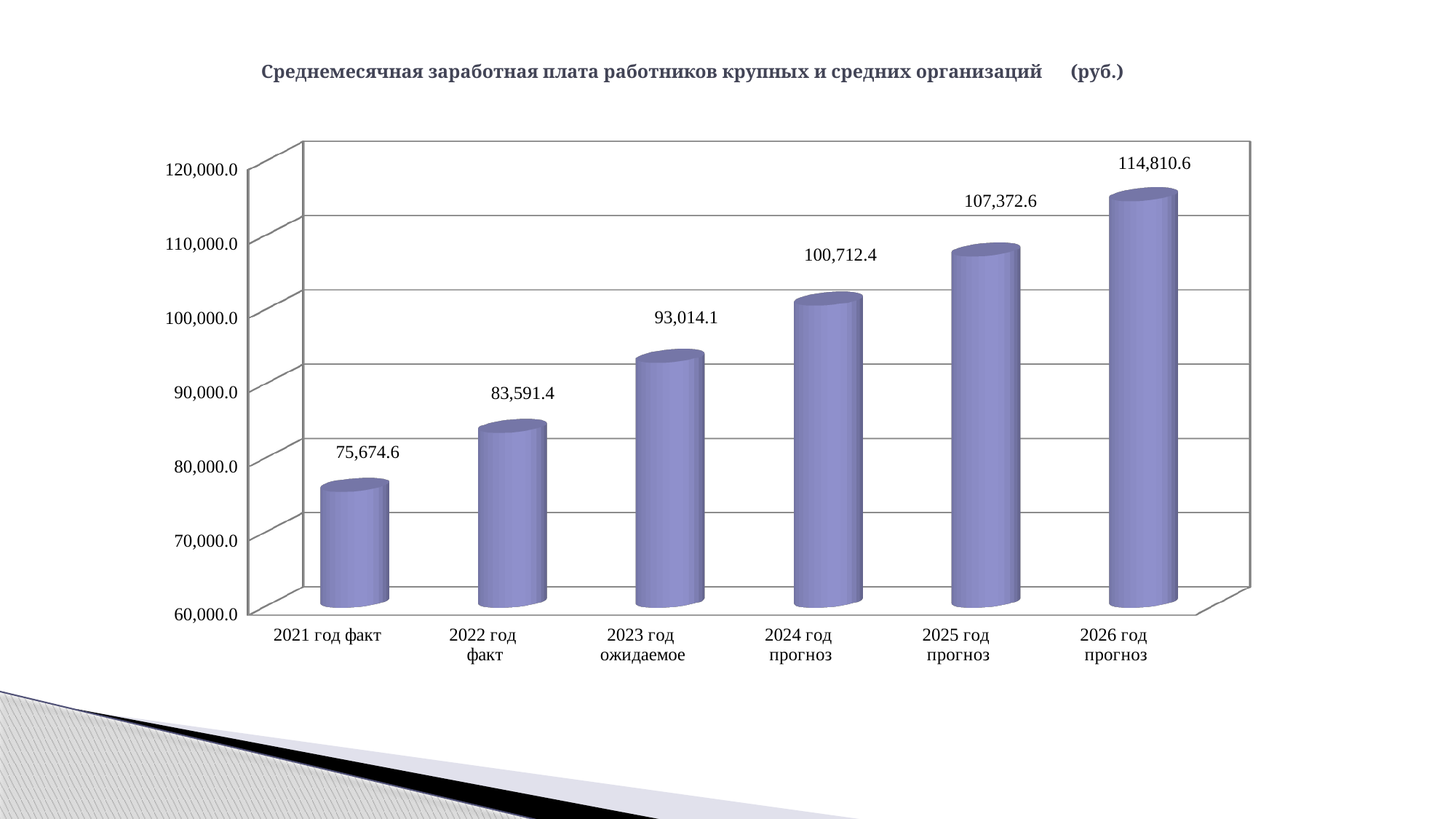
What is the difference between the values for 2022 год факт and 2021 год факт? 7,916.8 What is the value for 2025 год прогноз? 107,372.6 What is the value for 2023 год ожидаемое? 93,014.1 Is the value for 2024 год прогноз greater or less than 100,000.0? greater Which is larger, the value for 2024 год прогноз or the value for 2023 год ожидаемое? 2024 год прогноз Do the values rise or fall from 2021 год факт to 2026 год прогноз? rise What is the difference between the values for 2026 год прогноз and 2025 год прогноз? 7,438.0 Which category has the lowest value? 2021 год факт What is the value for 2021 год факт? 75,674.6 What kind of chart is shown on the slide? bar chart Which category has the highest value? 2026 год прогноз How many categories are shown on the x axis? 6